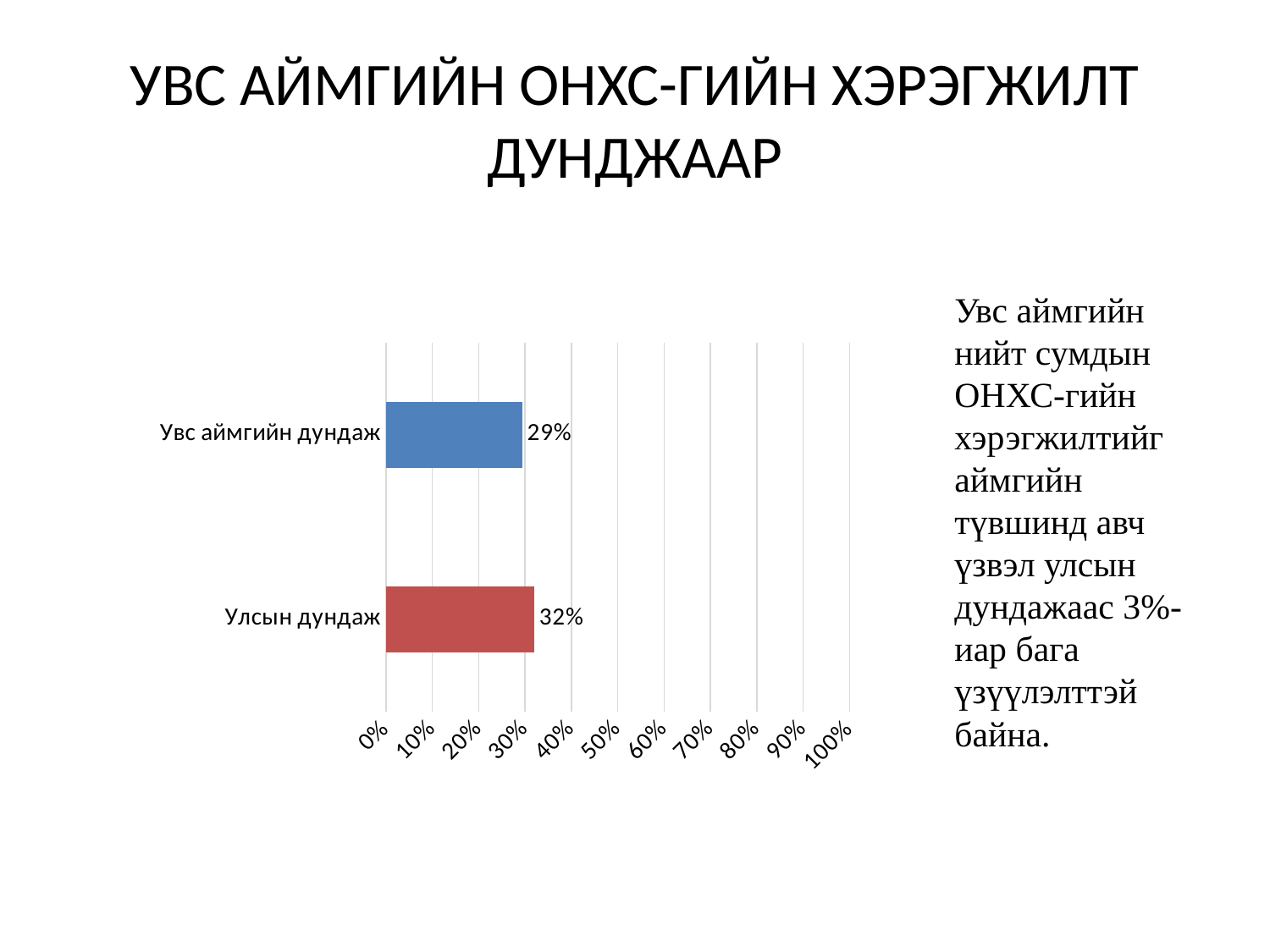
How many categories are shown in the chart? 2 What kind of chart is shown on the slide? Bar chart What colour is the bar for Улсын дундаж? Red What is the highest value shown on the chart's axis? 100% What is the value for Увс аймгийн дундаж? 29% What is the difference between the values for Улсын дундаж and Увс аймгийн дундаж? 3% Which category has the lowest value? Увс аймгийн дундаж Is the value for Улсын дундаж greater or less than 50%? less Which is larger, the value for Увс аймгийн дундаж or the value for Улсын дундаж? Улсын дундаж Which category has the highest value? Улсын дундаж What is the value for Улсын дундаж? 32% Is the value for Увс аймгийн дундаж greater or less than 20%? greater